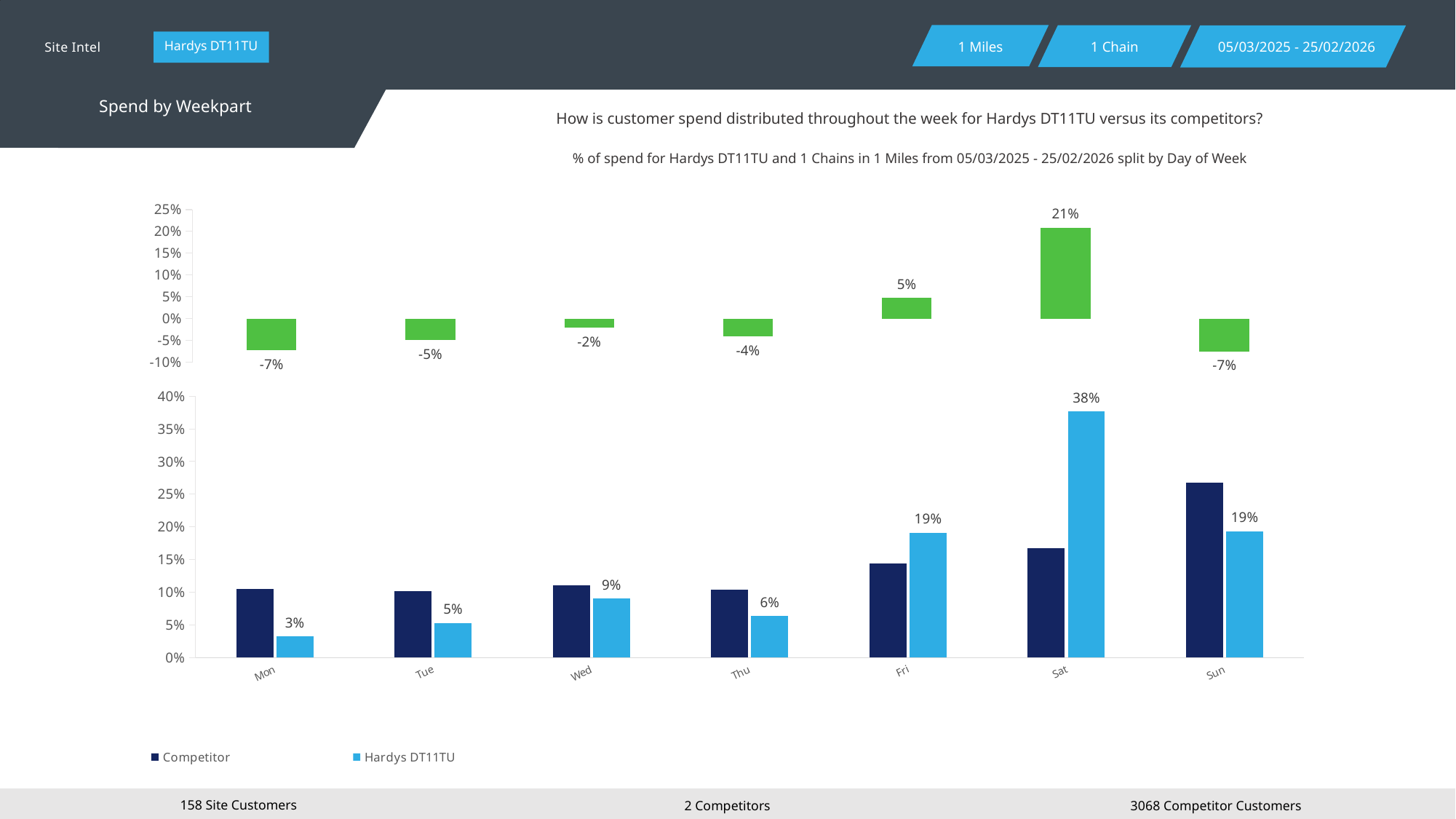
How many days of the week are shown on the x axis of the bottom chart? 7 How many series does the legend of the bottom chart list? 2 In the top chart (green bars), what is the value for Wed? -2% In the bottom chart, which day has the lowest value for Hardys DT11TU? Mon What kind of chart is the bottom chart? Bar chart In the top chart (green bars), what is the value for Sat? 21% In the bottom chart, what is the difference between the Hardys DT11TU values for Sat and Fri? 19% In the bottom chart, is the Competitor value for Sun greater or less than 25%? greater In the top chart (green bars), which day has the highest value? Sat In the bottom chart, on Sun, which is larger: Competitor or Hardys DT11TU? Competitor In the bottom chart, is the Competitor value for Sat greater or less than 20%? less In the bottom chart, what is the value for Hardys DT11TU on Sat? 38%